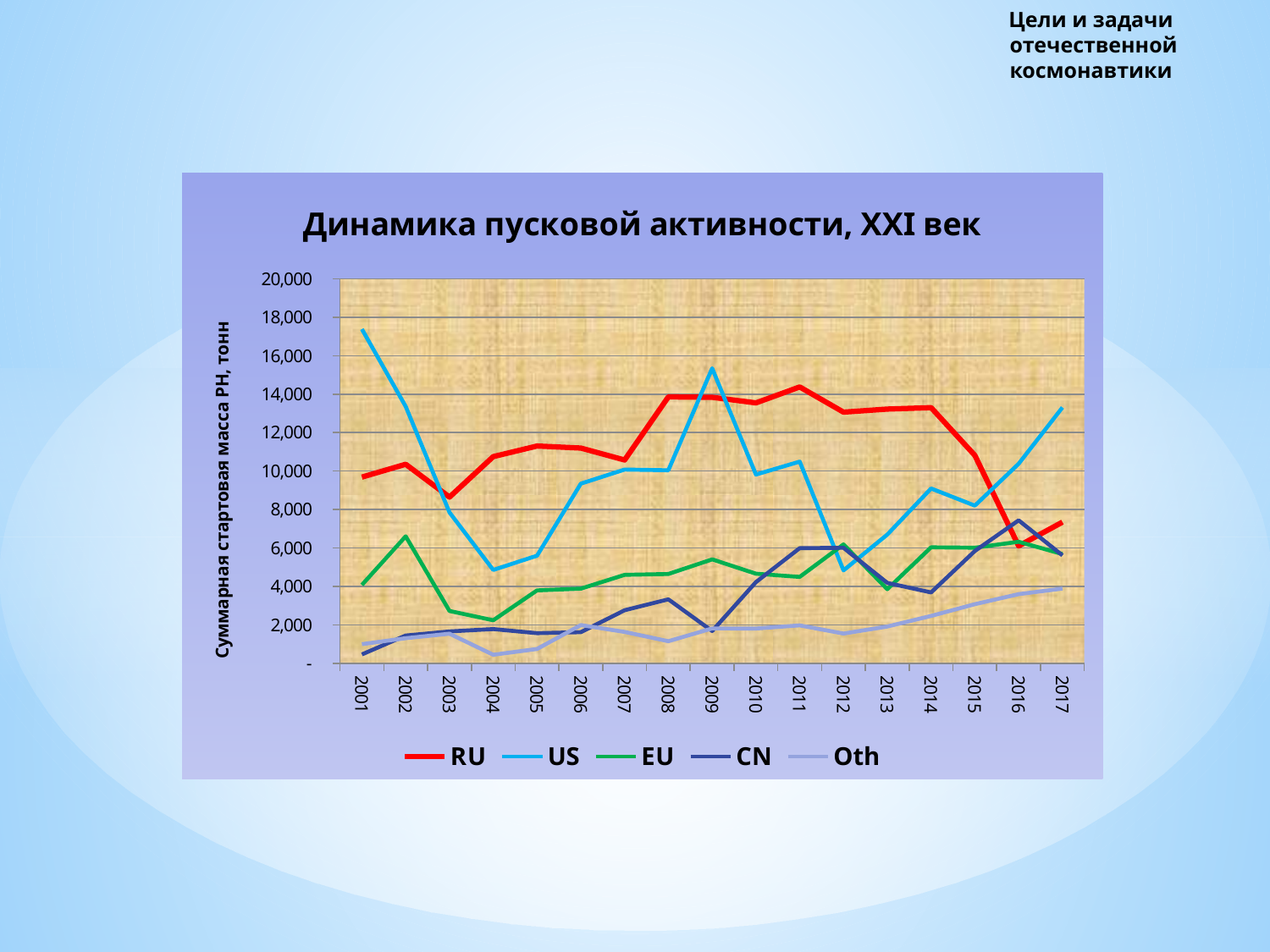
Is the value for RU in 2017 greater or less than 8,000? less What kind of chart is shown on the slide? line chart Which series has the highest value in 2001? US What is the label of the vertical axis? Суммарная стартовая масса РН, тонн What is the title of the chart? Динамика пусковой активности, XXI век In 2017, which is larger, the value for US or the value for RU? US Is the value for US in 2001 greater or less than 16,000? greater How many series does the legend list? 5 How many years are plotted along the x axis? 17 Which series has the highest value in 2011? RU Is the value for US in 2004 greater or less than 6,000? less Does the US line rise or fall from 2001 to 2004? fall